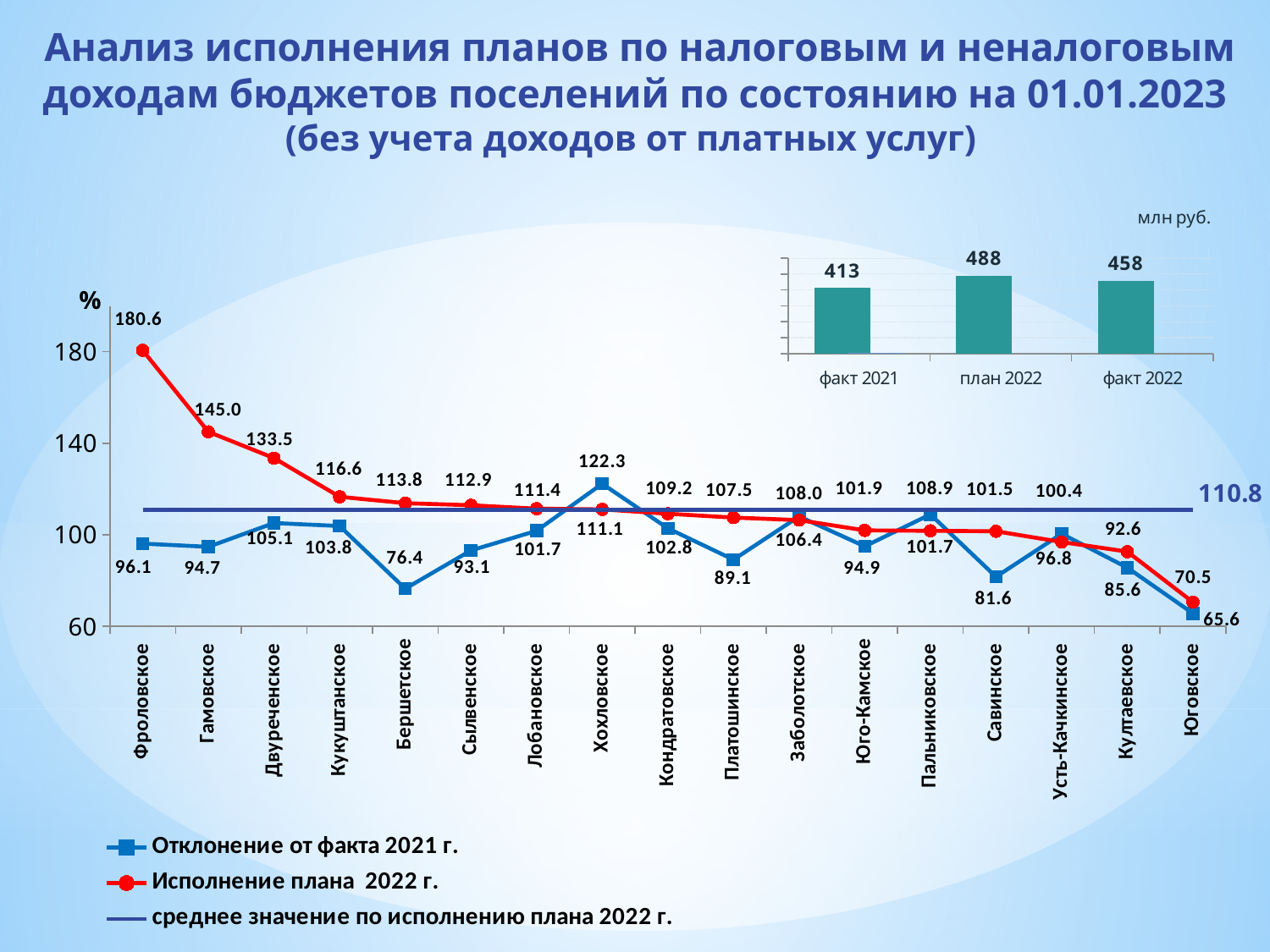
In the small bar chart at the top right, what is the difference between план 2022 and факт 2022? 30 In the large line chart, what is the value of the среднее значение по исполнению плана 2022 г. line? 110.8 In the large line chart, which settlement has the lowest value of Исполнение плана 2022 г.? Юговское In the large line chart, what is the difference between Исполнение плана 2022 г. and Отклонение от факта 2021 г. for Бершетское? 37.4 In the large line chart, which settlement has the highest value of Отклонение от факта 2021 г.? Хохловское In the small bar chart at the top right, how many bars are there? 3 In the large line chart, what is the value of Отклонение от факта 2021 г. for Хохловское? 122.3 In the small bar chart at the top right, which category has the lowest value? факт 2021 In the large line chart, which is larger for Савинское: Исполнение плана 2022 г. or Отклонение от факта 2021 г.? Исполнение плана 2022 г. In the small bar chart at the top right, what is the value for план 2022? 488 In the large line chart, how many series does the legend list? 3 In the large line chart, what is the value of Исполнение плана 2022 г. for Фроловское? 180.6